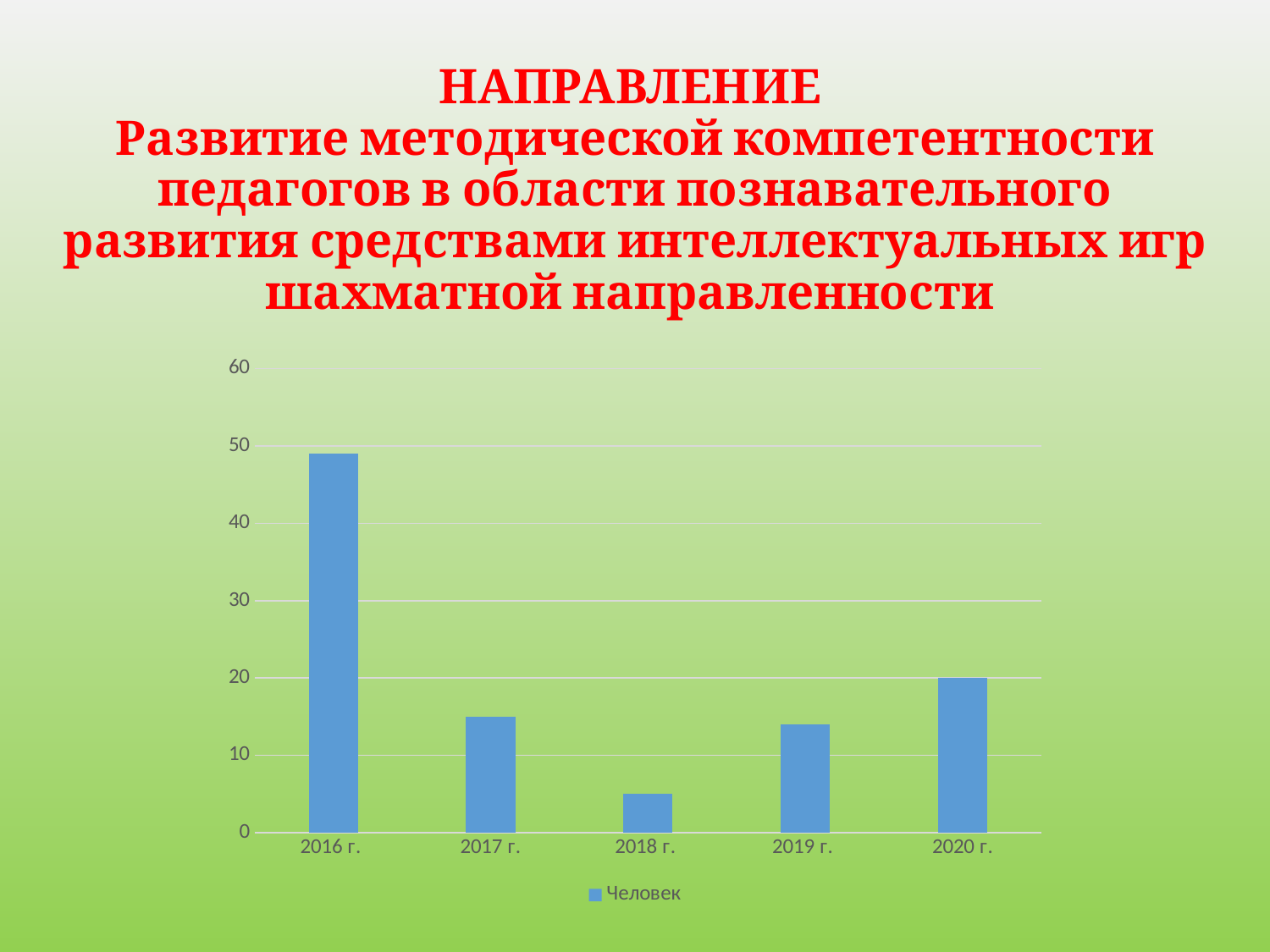
What is the name of the series in the chart legend? Человек Is the value for 2017 г. greater or less than 10? greater Is the value for 2018 г. greater or less than 10? less Which is larger, the value for 2020 г. or the value for 2017 г.? 2020 г. Is the value for 2019 г. greater or less than 20? less How many series does the chart legend list? 1 Which year has the highest value in the chart? 2016 г. Which year has the lowest value in the chart? 2018 г. How many years are shown on the x axis of the chart? 5 What kind of chart is shown on the slide? bar chart Do the values rise or fall from 2018 г. to 2020 г.? rise